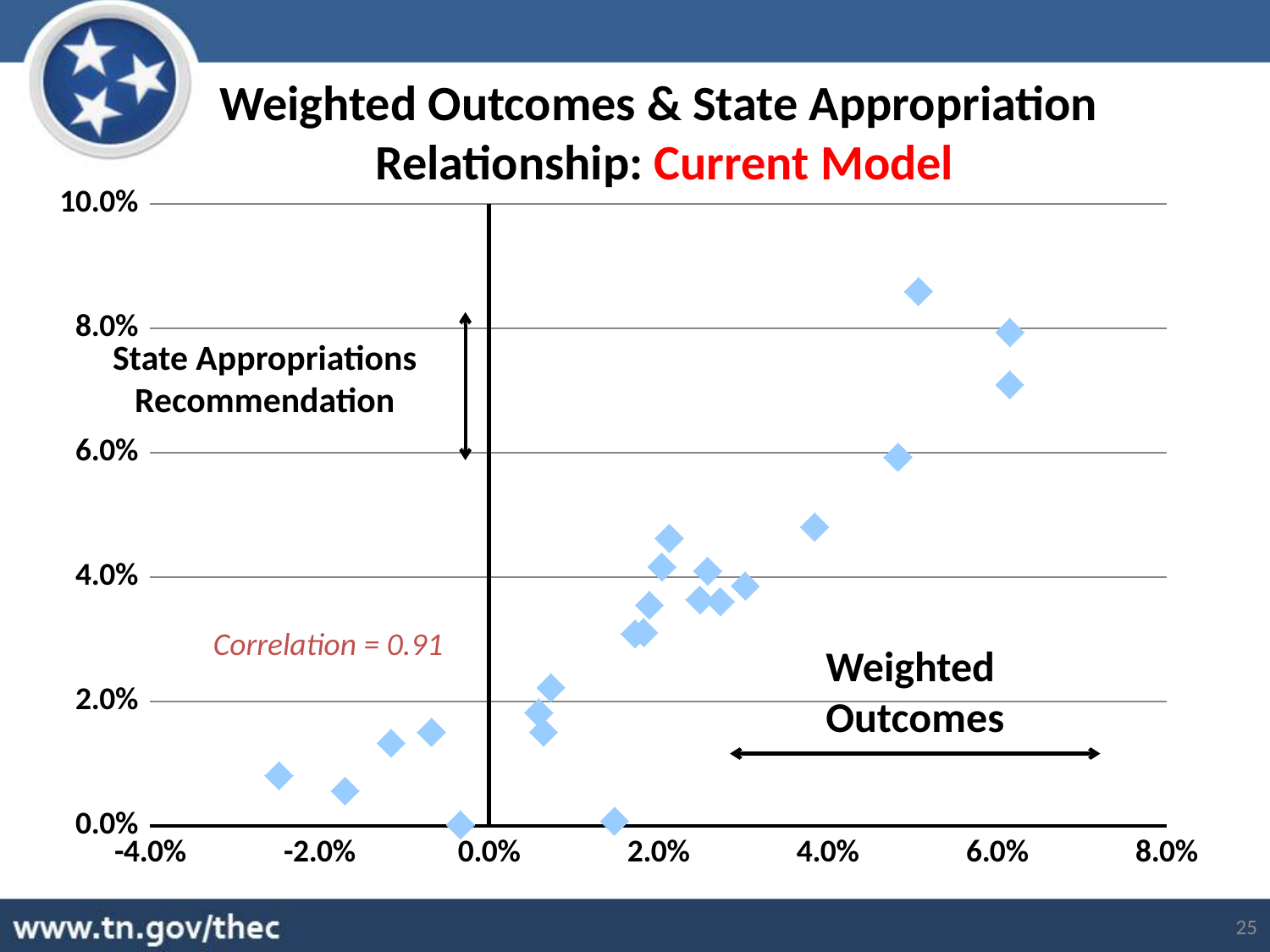
Is the Weighted Outcomes value of the highest plotted point greater or less than 4.0%? greater What kind of chart is shown on the slide? scatter plot What correlation value is printed on the chart? 0.91 What label is given to the vertical axis of the chart? State Appropriations Recommendation Is the Weighted Outcomes value of the leftmost plotted point greater or less than -2.0%? less Is the State Appropriations Recommendation of the highest plotted point greater or less than 8.0%? greater As Weighted Outcomes increase along the x axis, do the State Appropriations Recommendation values generally rise or fall? rise Are there more plotted points with positive Weighted Outcomes or with negative Weighted Outcomes? positive